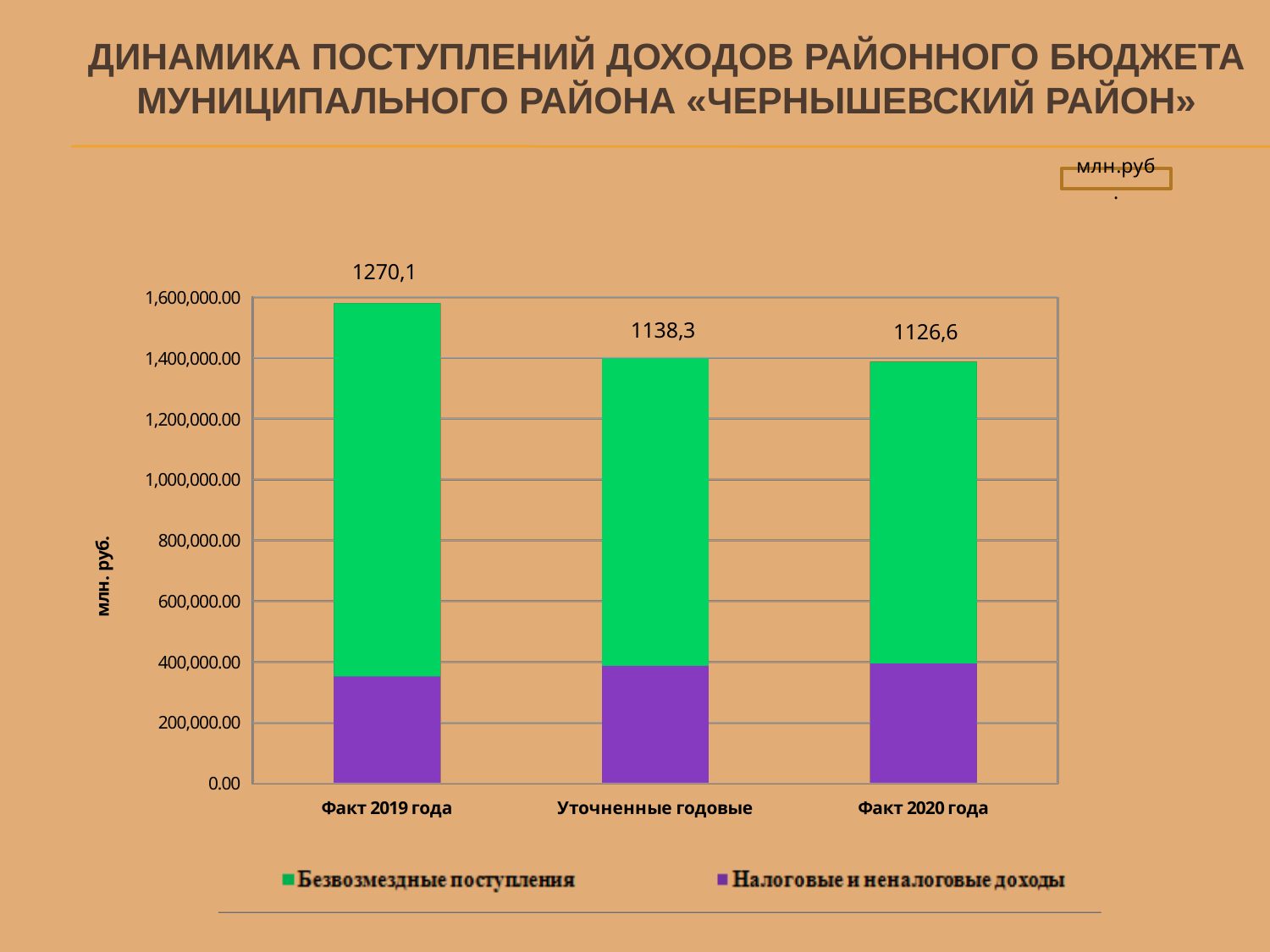
What total value is printed above the bar for Факт 2019 года? 1270,1 Do the total values rise or fall from Факт 2019 года to Факт 2020 года? Fall How many series does the legend list? 2 Which category has the highest total value? Факт 2019 года Which category has the lowest total value? Факт 2020 года Which is larger, the total for Факт 2019 года or the total for Факт 2020 года? Факт 2019 года What kind of chart is shown on the slide? Stacked bar chart What total value is printed above the bar for Уточненные годовые? 1138,3 What is the difference between the printed totals for Факт 2019 года and Факт 2020 года? 143,5 Is the Налоговые и неналоговые доходы segment for Факт 2019 года greater or less than 400,000.00? less What total value is printed above the bar for Факт 2020 года? 1126,6 How many categories are shown on the x axis? 3